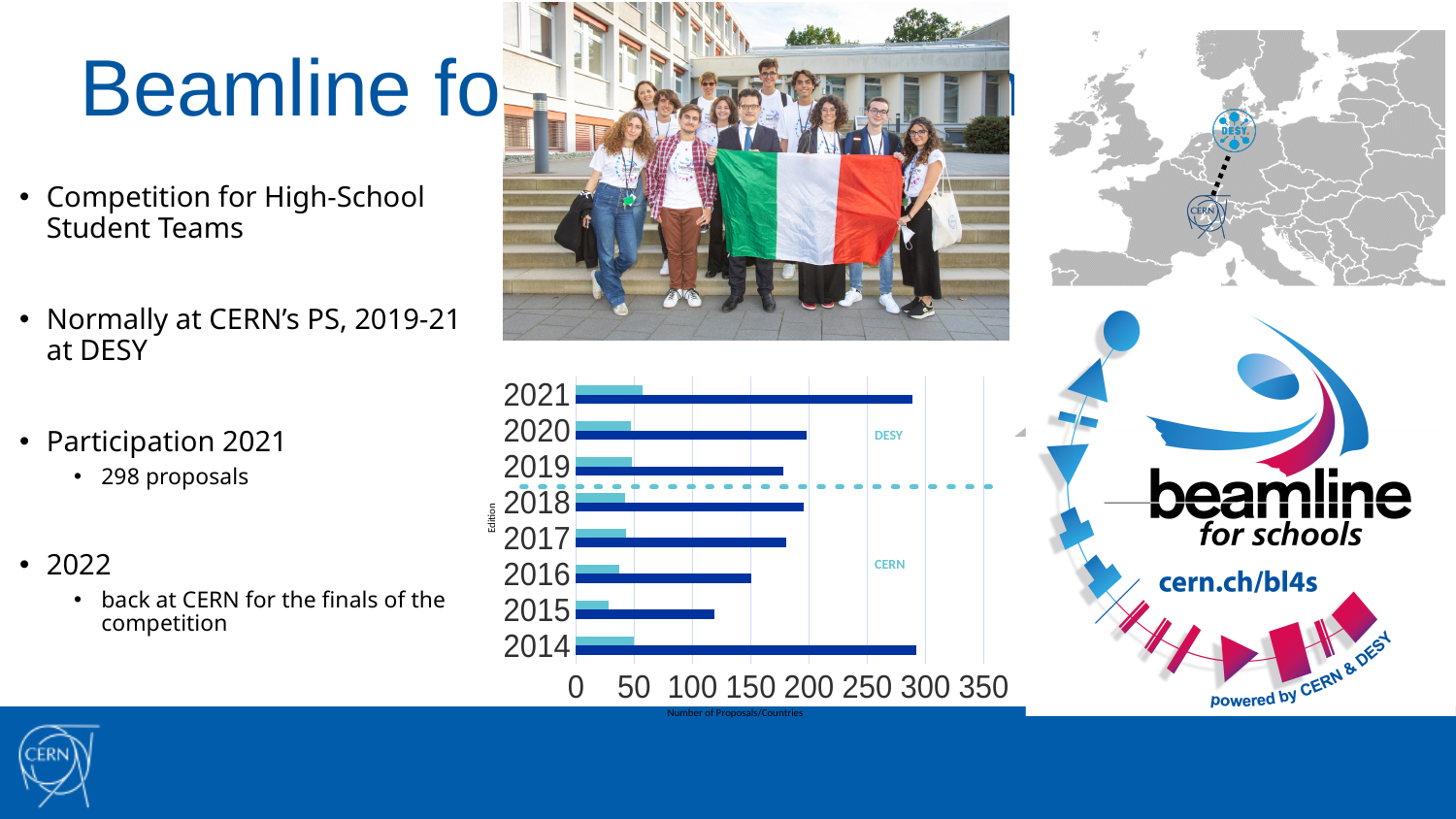
Is the dark blue bar for 2021 greater or less than 250? greater Is the dark blue bar for 2017 greater or less than 200? less Is the dark blue bar for 2014 greater or less than 250? greater How many editions (years) are listed on the chart's vertical axis? 8 What is the title of the chart's horizontal axis? Number of Proposals/Countries What kind of chart is shown on the slide? bar chart Which edition has the shortest dark blue bar? 2015 Which has the longer dark blue bar, 2016 or 2017? 2017 What is the title of the chart's vertical axis? Edition Which has the longer dark blue bar, 2021 or 2015? 2021